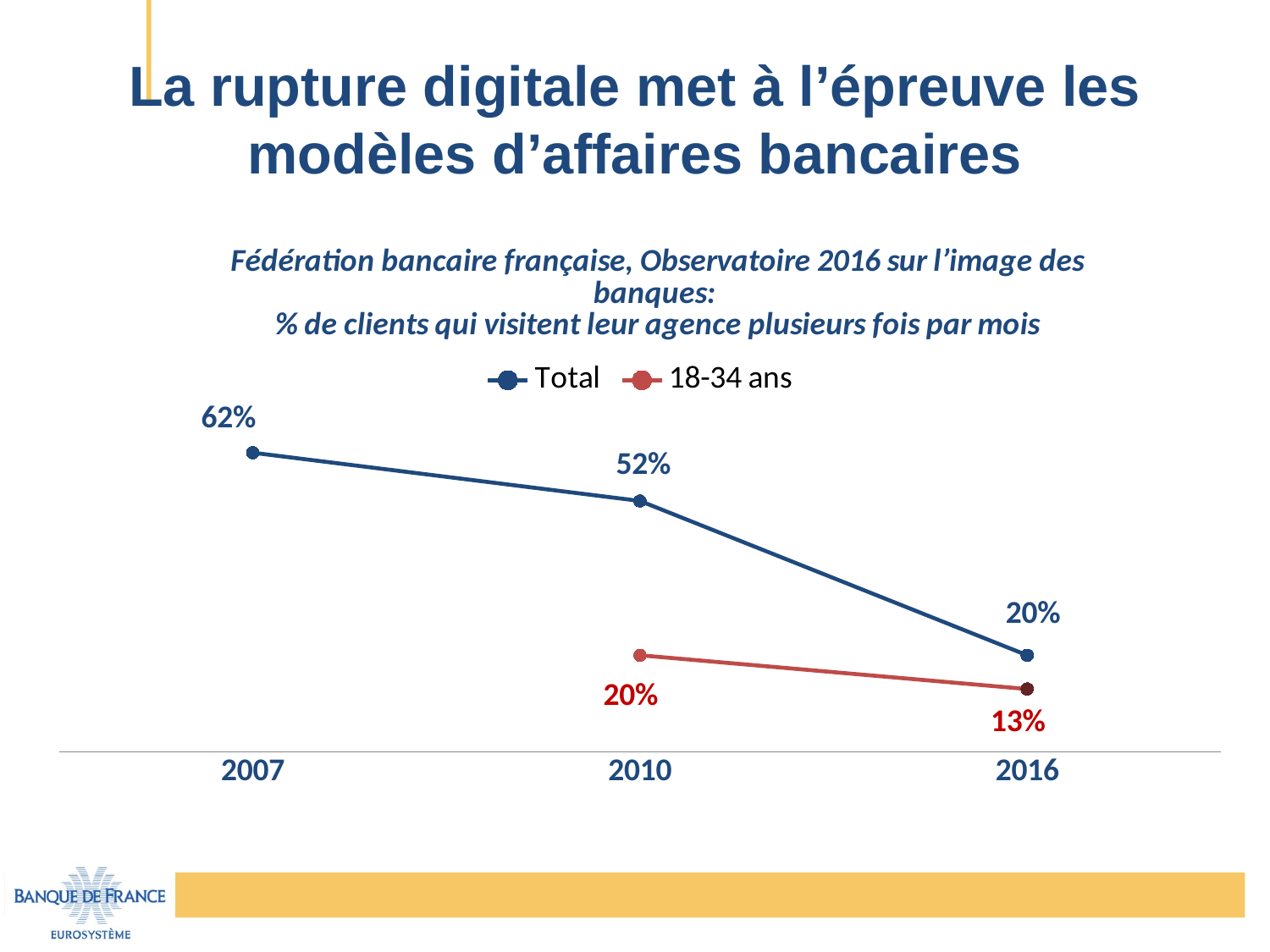
What is the value for Total in 2007? 62% What is the difference between Total and 18-34 ans in 2016? 7% How many series does the legend list? 2 Which is larger in 2010, Total or 18-34 ans? Total What kind of chart is shown on the slide? Line chart What is the difference between the Total values for 2007 and 2016? 42% What is the value for 18-34 ans in 2016? 13% What is the value for Total in 2010? 52% In which year is the Total series highest? 2007 What is the value for Total in 2016? 20% What is the value for 18-34 ans in 2010? 20% In which year is the Total series lowest? 2016